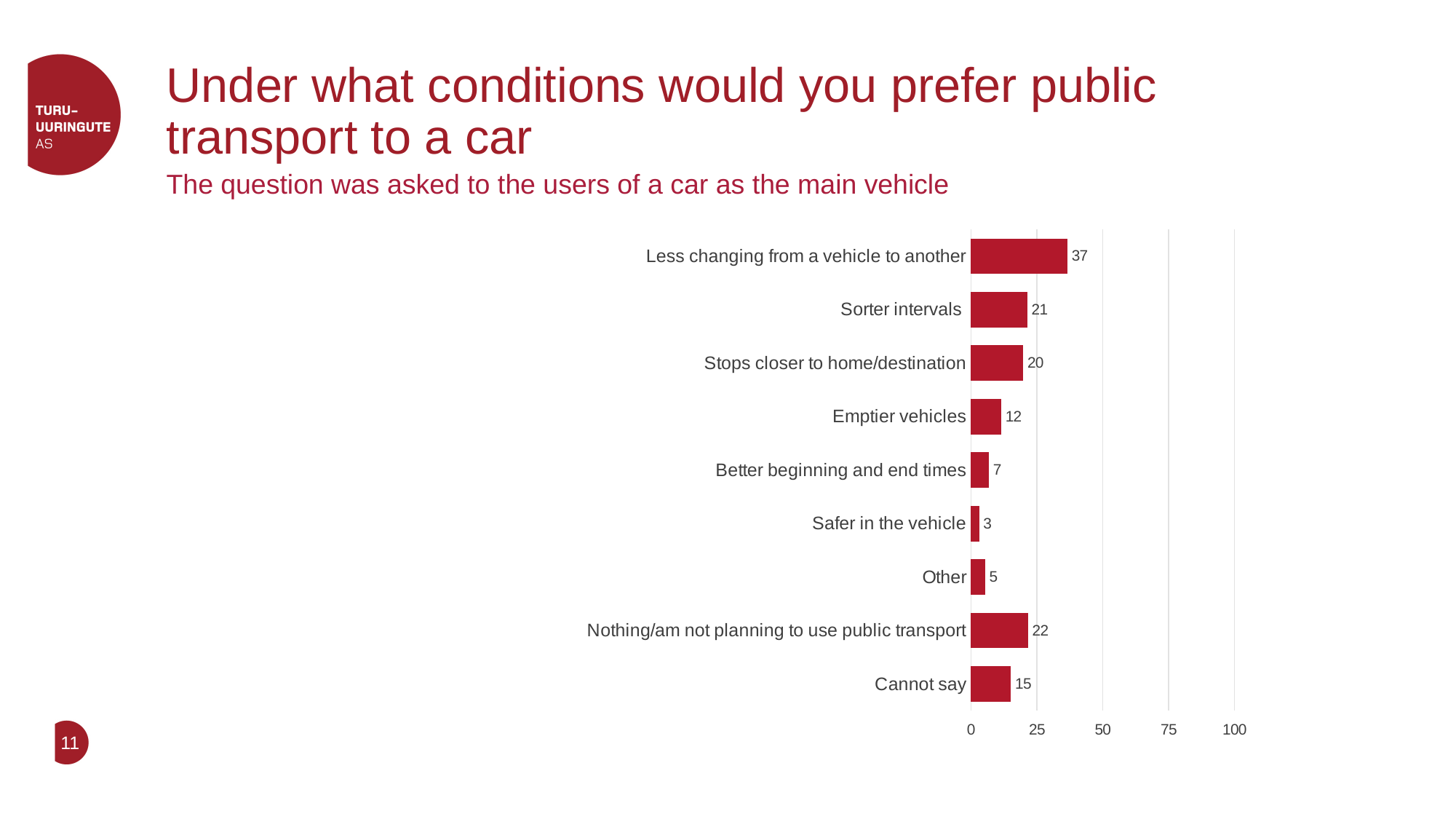
What is the value for "Less changing from a vehicle to another"? 37 What is the value for "Cannot say"? 15 Which is larger, the value for "Emptier vehicles" or the value for "Better beginning and end times"? Emptier vehicles What is the value for "Stops closer to home/destination"? 20 Which category has the lowest value? Safer in the vehicle Which category has the highest value? Less changing from a vehicle to another What is the difference between the values for "Less changing from a vehicle to another" and "Sorter intervals"? 16 What is the highest tick value shown on the horizontal axis? 100 Is the value for "Less changing from a vehicle to another" greater or less than 25? greater What kind of chart is shown on the slide? bar chart How many categories are shown in the chart? 9 What is the value for "Nothing/am not planning to use public transport"? 22